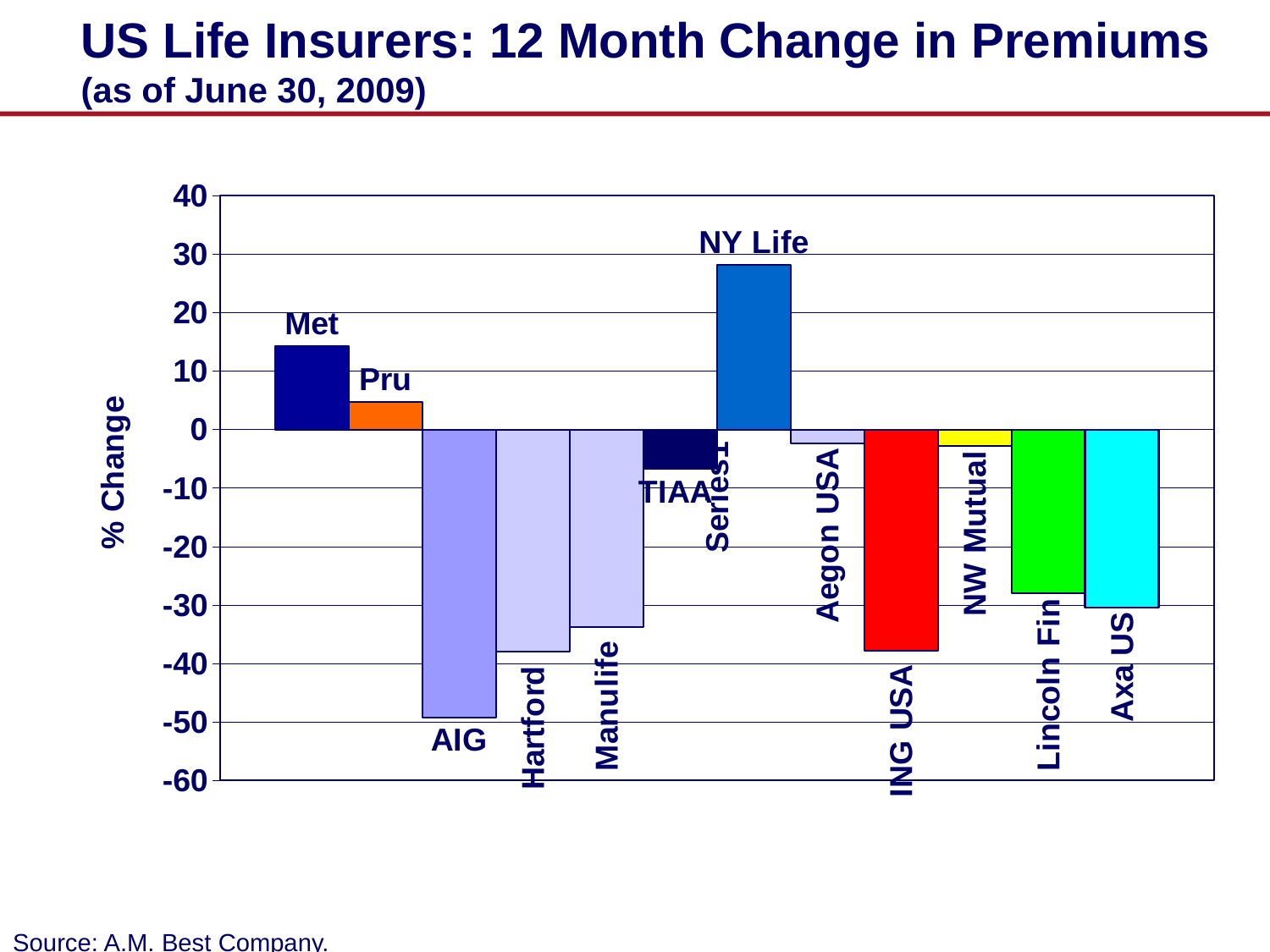
Is the value for Lincoln Fin greater or less than -20? less Is the value for Hartford greater or less than -30? less Which insurer has the lowest 12 month change in premiums? AIG Is the value for AIG greater or less than -40? less How many insurers are plotted in the chart? 12 Which has a larger 12 month change in premiums, Met or Pru? Met What is the label on the vertical axis of the chart? % Change What kind of chart is shown on the slide? bar chart Which insurer has the highest 12 month change in premiums? NY Life